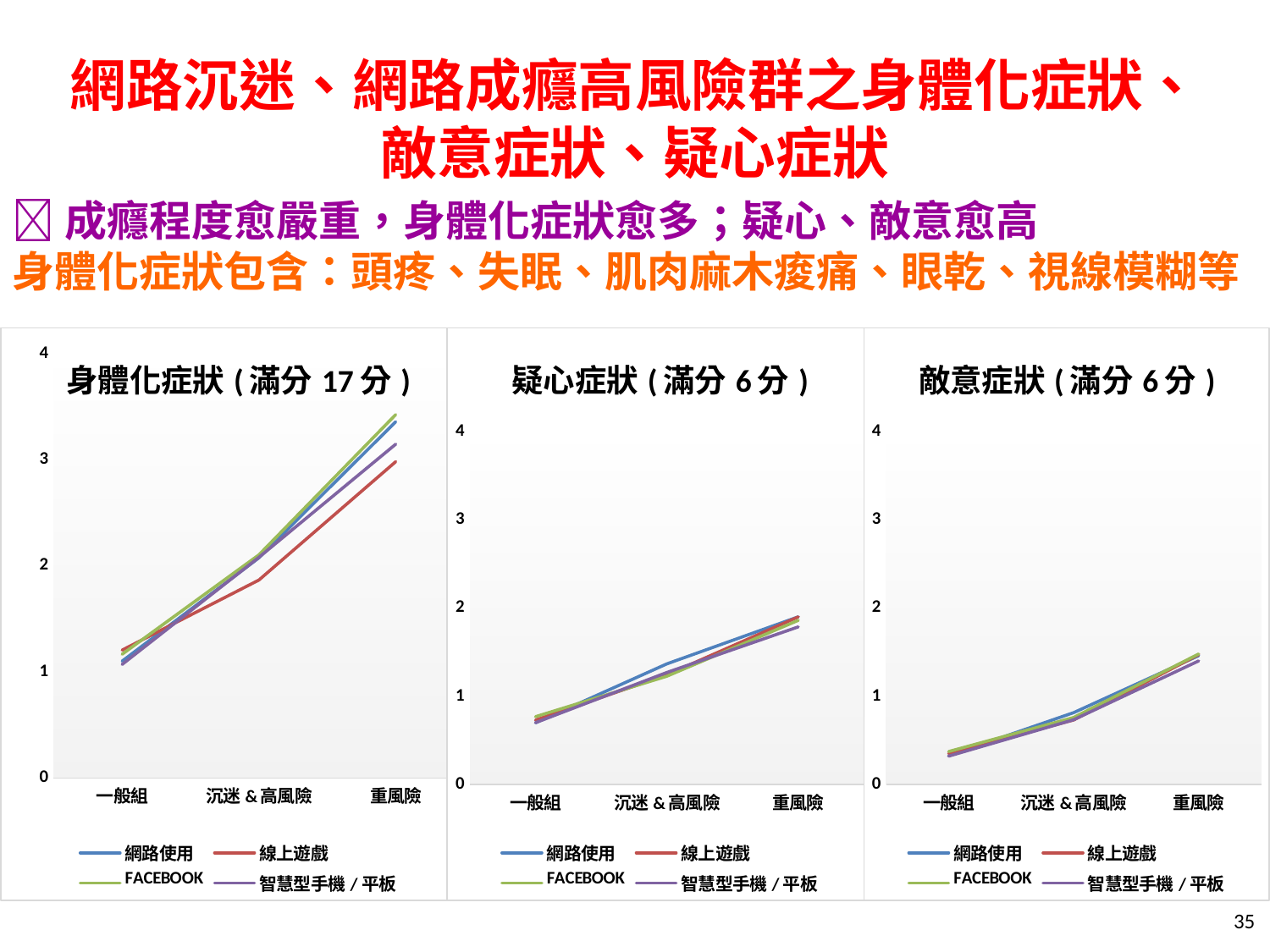
In the 敵意症狀 (滿分 6 分) chart, is the value for 網路使用 at 一般組 greater or less than 1? less In the 敵意症狀 (滿分 6 分) chart, do the lines rise or fall along the x axis? rise In the 敵意症狀 (滿分 6 分) chart, is the value for FACEBOOK at 重風險 greater or less than 1? greater In the 身體化症狀 (滿分 17 分) chart, is the value for 線上遊戲 at 沉迷 & 高風險 greater or less than 2? less What kind of chart is the 身體化症狀 (滿分 17 分) chart? line chart In the 身體化症狀 (滿分 17 分) chart, which series has the lowest value at 重風險? 線上遊戲 How many series does the legend of the 敵意症狀 (滿分 6 分) chart list? 4 How many categories are shown on the x axis of the 疑心症狀 (滿分 6 分) chart? 3 In the 身體化症狀 (滿分 17 分) chart, do the values rise or fall from 一般組 to 重風險? rise In the 身體化症狀 (滿分 17 分) chart, at 重風險, which is larger: FACEBOOK or 線上遊戲? FACEBOOK